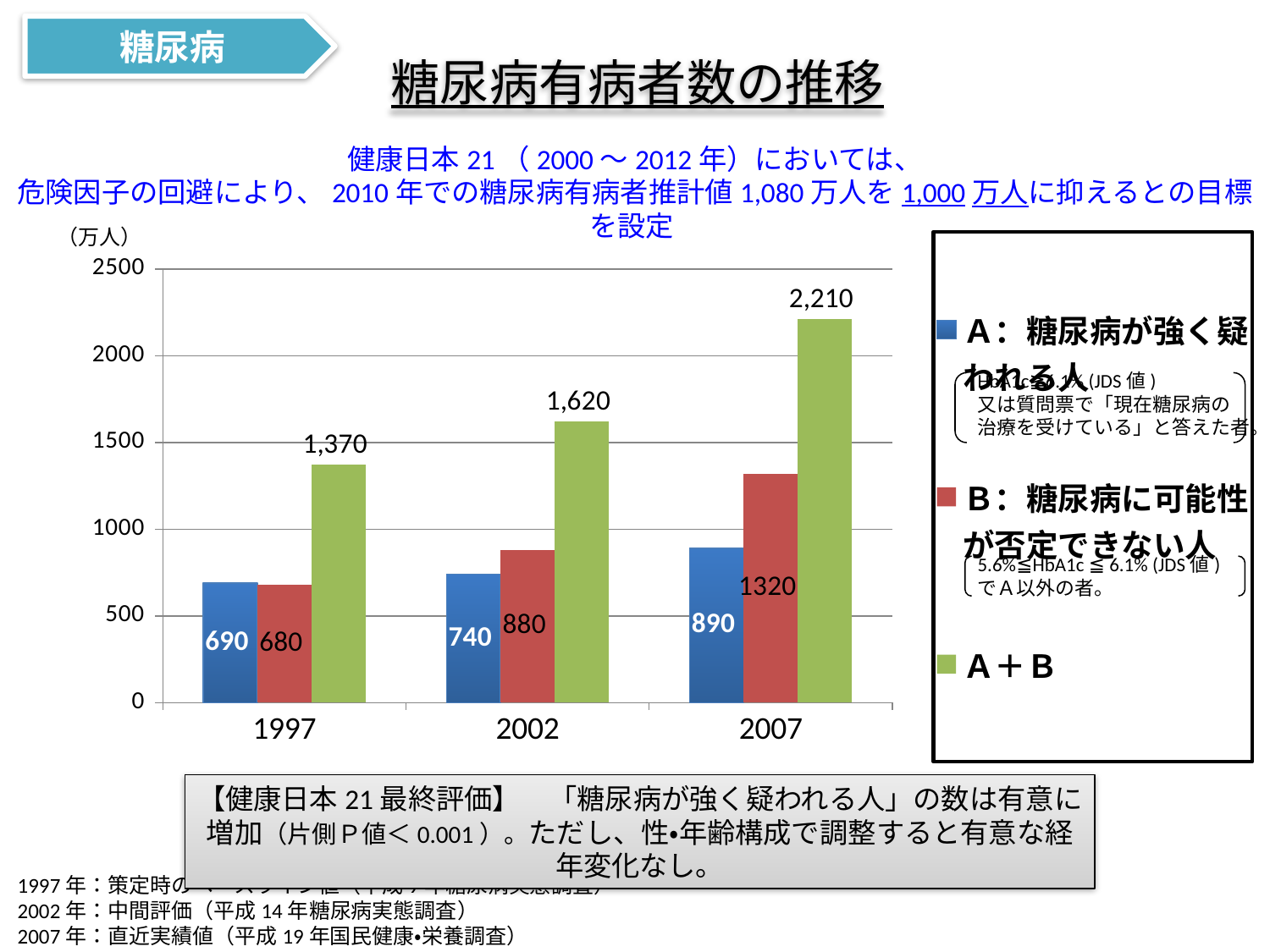
How many years are shown on the x axis? 3 What is the difference between the A＋B values for 2007 and 1997? 840 Is the value of series B for 2007 greater or less than 1000? greater What kind of chart is shown on the slide? Bar chart What is the value of series B (糖尿病に可能性が否定できない人) for 2007? 1320 In which year is the A＋B series highest? 2007 In which year is series B (糖尿病に可能性が否定できない人) lowest? 1997 How many series does the legend list? 3 Does series A (糖尿病が強く疑われる人) rise or fall from 1997 to 2007? Rise Which is larger in 2002: series A or series B? Series B What is the value of series A (糖尿病が強く疑われる人) for 1997? 690 What is the value of the A＋B series for 2002? 1,620